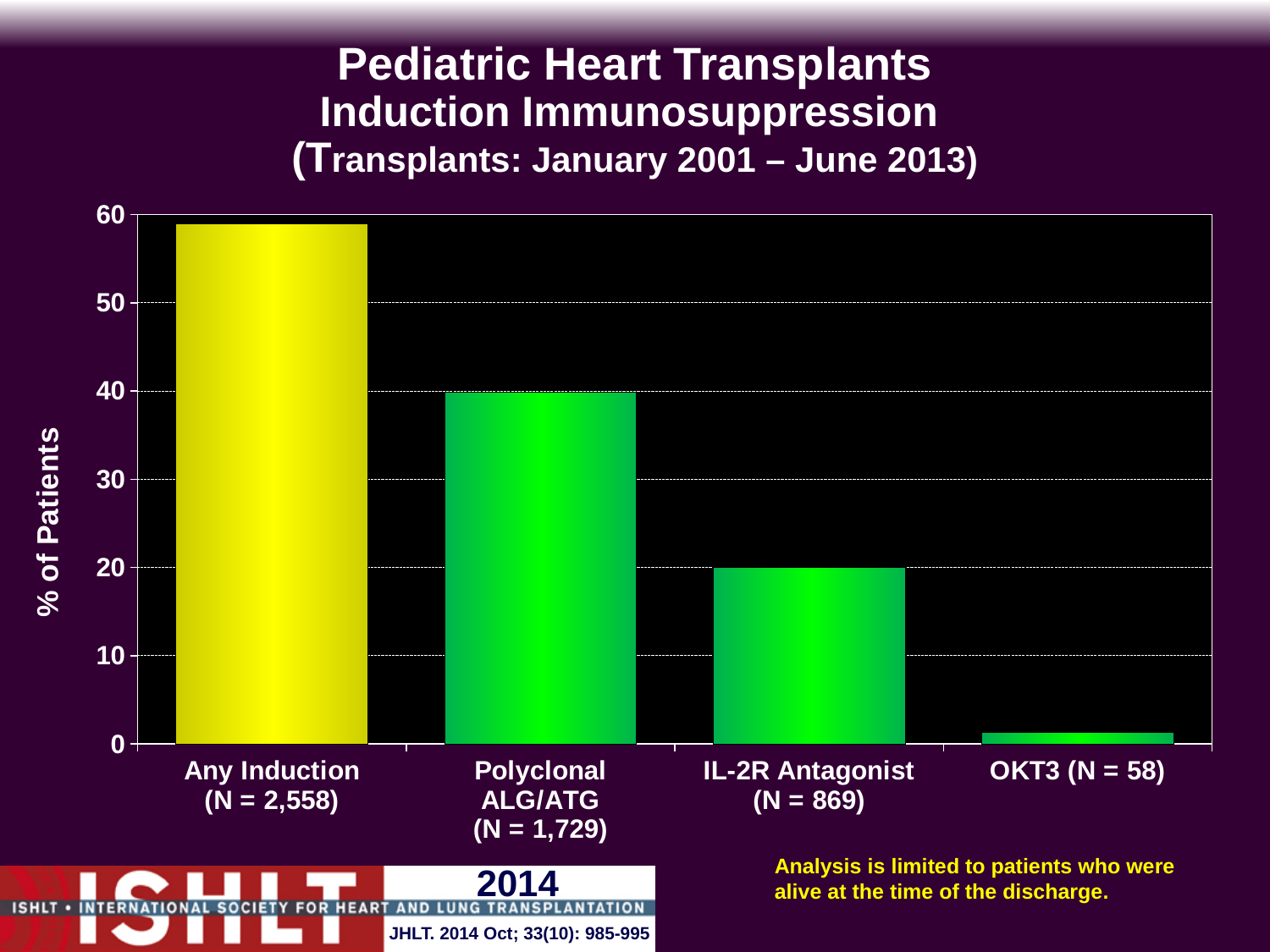
What is the N shown for the IL-2R Antagonist category? 869 Is the value for Any Induction greater or less than 50? greater Which category has the lowest % of patients? OKT3 (N = 58) Which has a larger % of patients, Polyclonal ALG/ATG or IL-2R Antagonist? Polyclonal ALG/ATG What kind of chart is shown on the slide? bar chart How many categories are plotted on the x axis? 4 Do the bar values rise or fall from left to right along the x axis? fall Is the value for IL-2R Antagonist greater or less than 30? less Is the value for Polyclonal ALG/ATG greater or less than 30? greater Which category has the highest % of patients? Any Induction (N = 2,558) What is the label of the y axis? % of Patients